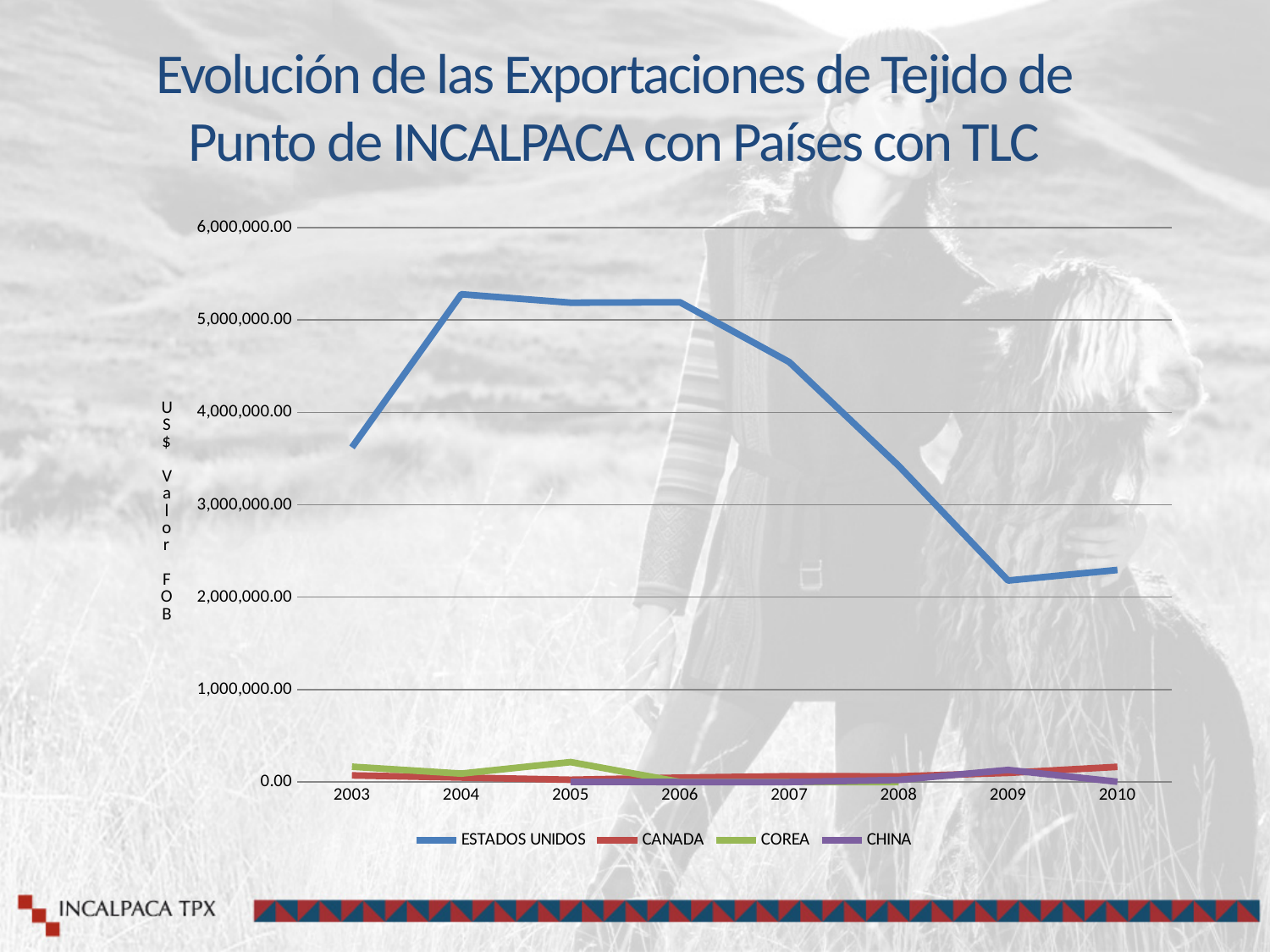
Is the value for ESTADOS UNIDOS in 2003 greater or less than 3,000,000.00? greater Is the value for ESTADOS UNIDOS in 2008 greater or less than 4,000,000.00? less How many series does the legend list? 4 What is the label on the vertical axis of the chart? US$ Valor FOB In which year does the ESTADOS UNIDOS series reach its highest value? 2004 Does the ESTADOS UNIDOS series rise or fall between 2006 and 2009? Fall What kind of chart is shown on the slide? Line chart Is the value for ESTADOS UNIDOS in 2004 greater or less than 5,000,000.00? greater Which is larger for ESTADOS UNIDOS: the value in 2004 or the value in 2008? 2004 Which series has the highest values across the chart? ESTADOS UNIDOS How many years are plotted along the x axis? 8 In which year does the ESTADOS UNIDOS series reach its lowest value? 2009